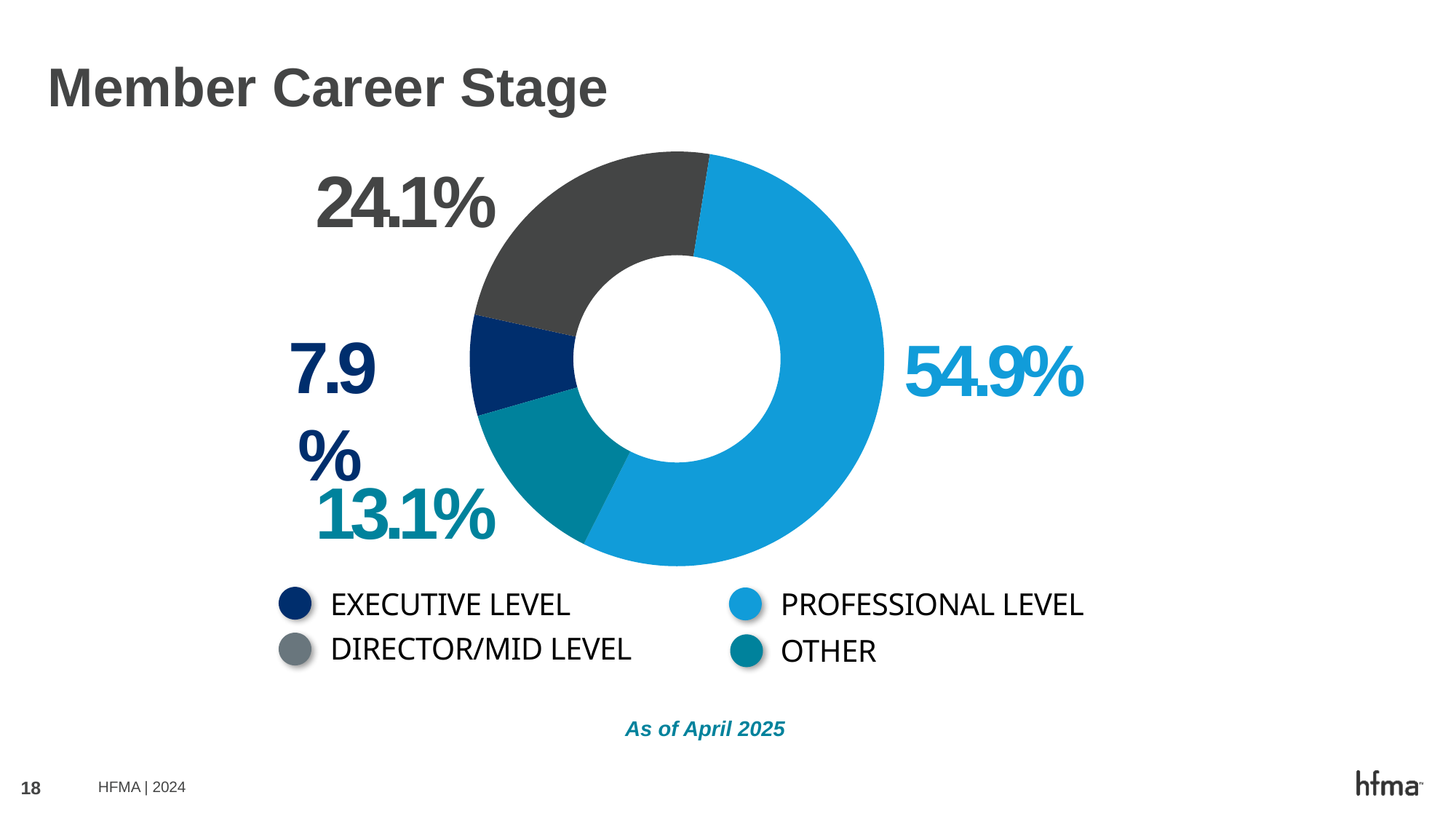
How many career stage categories are shown in the chart? 4 Which is larger, the share for Other or the share for Executive Level? Other Which career stage has the largest share of members? Professional Level What type of chart is used to show member career stage? Pie chart (donut) What is the title of the chart? Member Career Stage Which career stage has the smallest share of members? Executive Level As of what date is the chart data reported? April 2025 What is the difference in percentage points between the Professional Level and Director/Mid Level shares? 30.8 What percentage of members fall into the Other category? 13.1% What percentage of members are at the Professional Level? 54.9% What percentage of members are at the Director/Mid Level? 24.1% What percentage of members are at the Executive Level? 7.9%